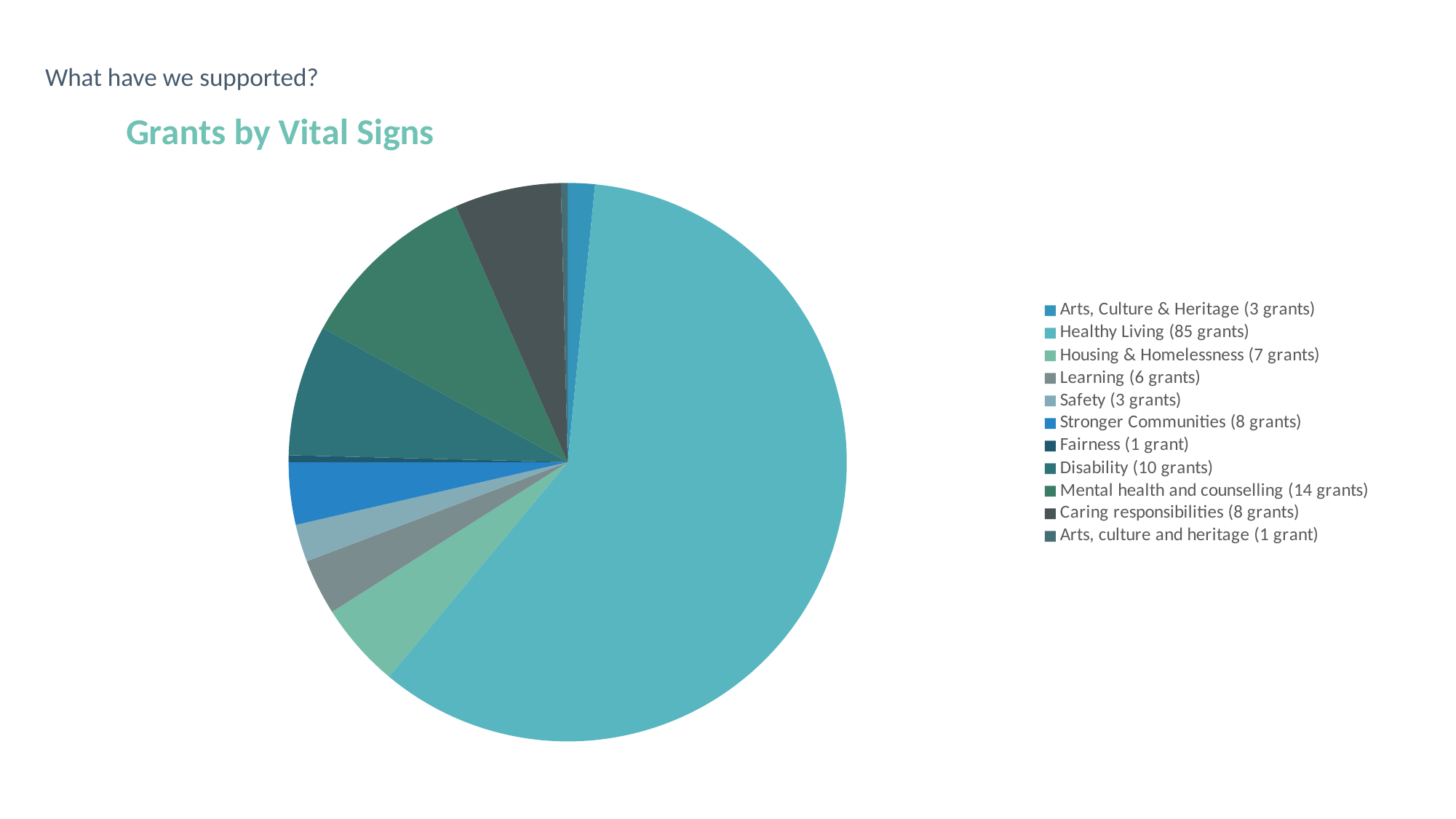
How many more grants does Healthy Living have than Mental health and counselling? 71 What is the title of the chart? Grants by Vital Signs How many grants does the legend show for Disability? 10 grants Which has more grants, Disability or Stronger Communities? Disability What type of chart is shown on the slide? Pie chart Which category has the largest slice of the pie? Healthy Living Which has more grants, Housing & Homelessness or Safety? Housing & Homelessness What is the difference in grants between Disability and Learning? 4 How many grants does the legend show for Healthy Living? 85 grants How many grants does the legend show for Fairness? 1 grant How many grants does the legend show for Mental health and counselling? 14 grants How many categories does the legend list? 11